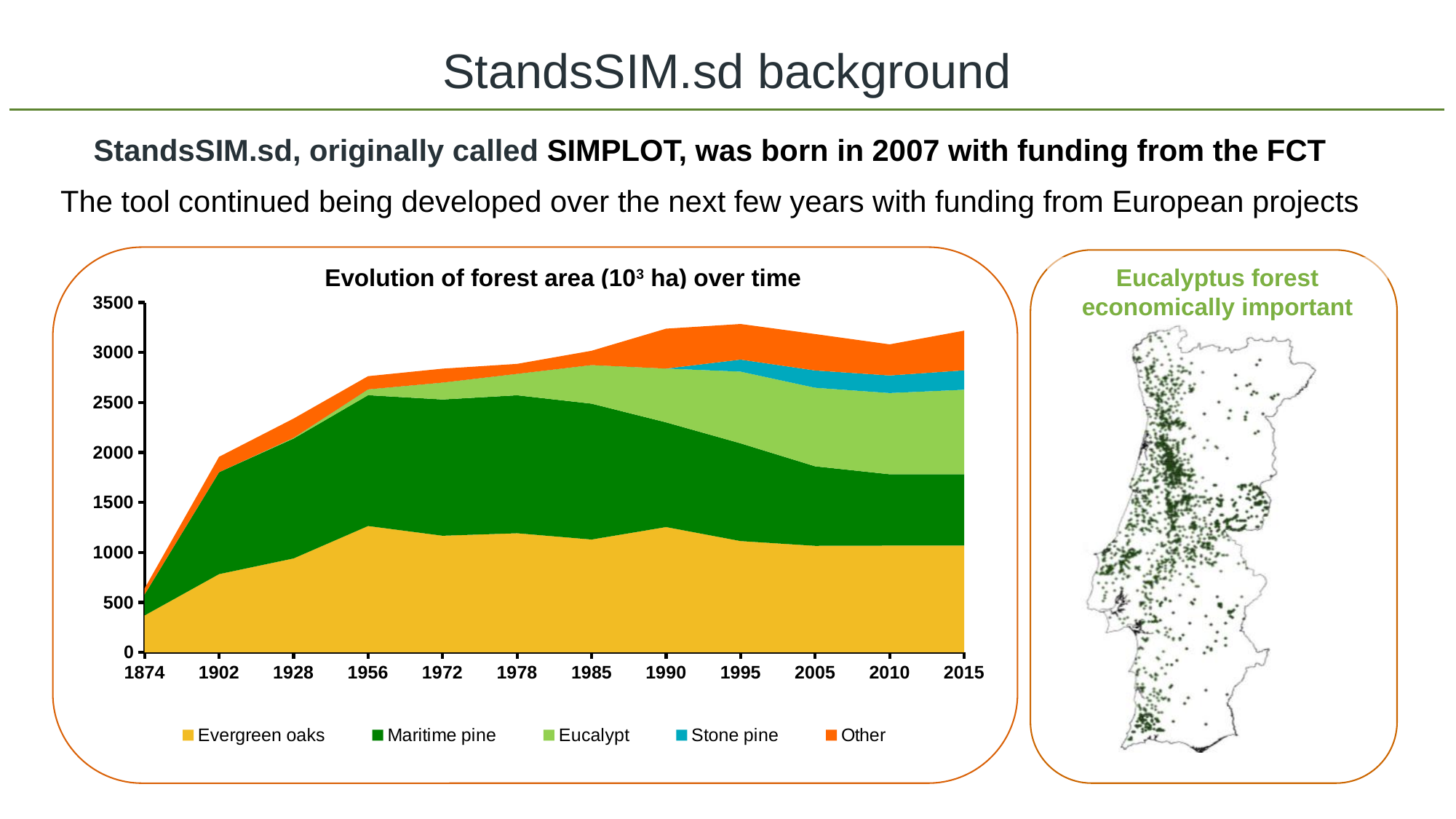
Is the value for Evergreen oaks in 1874 greater or less than 500? less Does the total forest area rise or fall between 1874 and 1956? Rise Is the total forest area in 1874 greater or less than 1000? less What is the title of the chart? Evolution of forest area (10³ ha) over time Is the total forest area in 1995 greater or less than 3000? greater How many years are marked along the x axis of the chart? 12 How many series does the chart's legend list? 5 What kind of chart is shown on the slide? Stacked area chart Which series is plotted at the bottom of the stack in the chart? Evergreen oaks Which year has the lowest total forest area in the chart? 1874